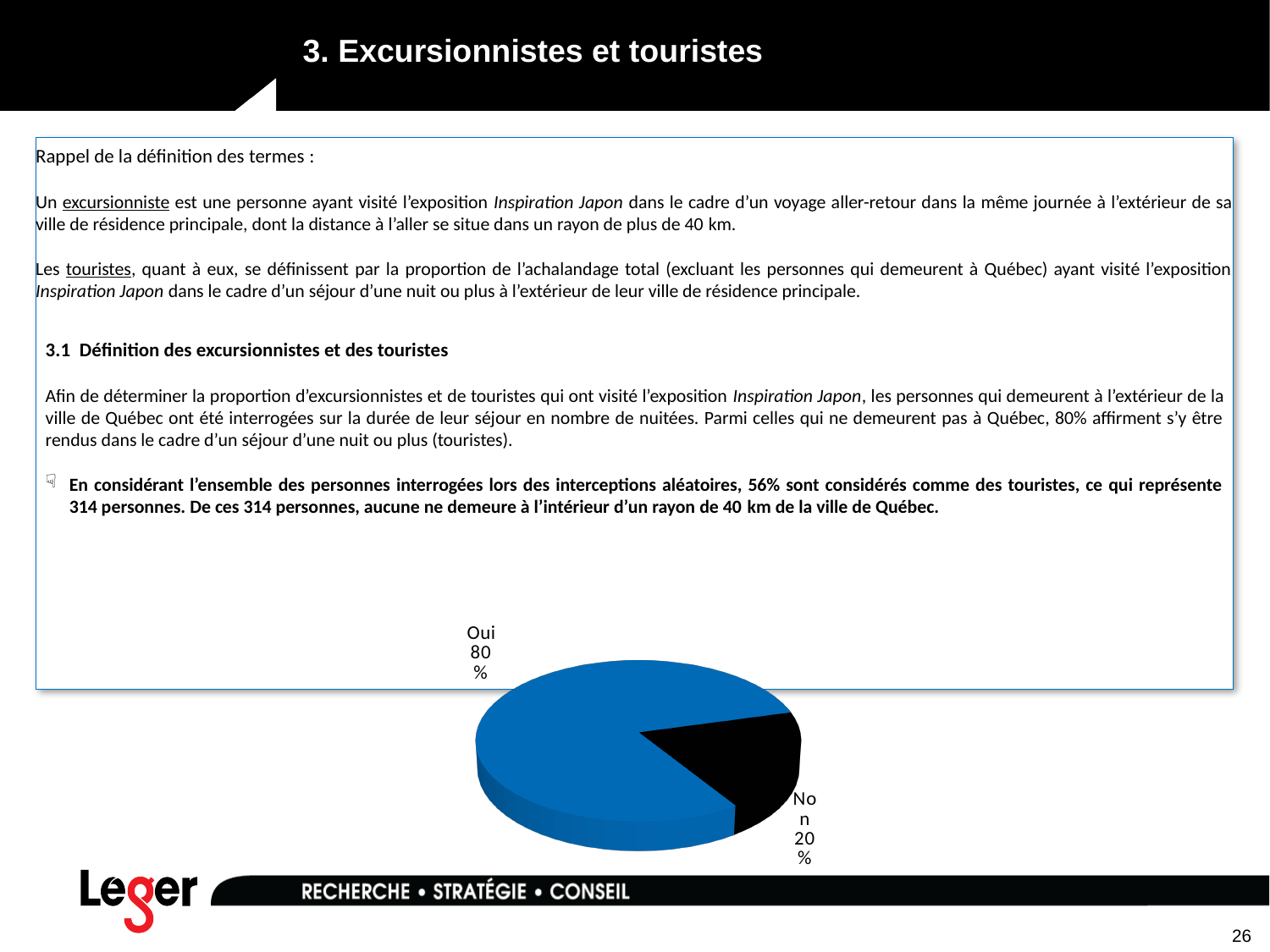
What colour is the Non slice of the pie chart? black What colour is the Oui slice of the pie chart? blue Which slice of the pie chart is the smallest? Non What share of the pie does the Oui slice represent? 80% How many slices does the pie chart have? 2 What kind of chart is shown on the slide? pie chart What is the value for Non in the pie chart? 20% Which slice of the pie chart is the largest? Oui Which is larger in the pie chart, Oui or Non? Oui What is the value for Oui in the pie chart? 80% What is the difference in percentage points between the Oui and Non slices? 60